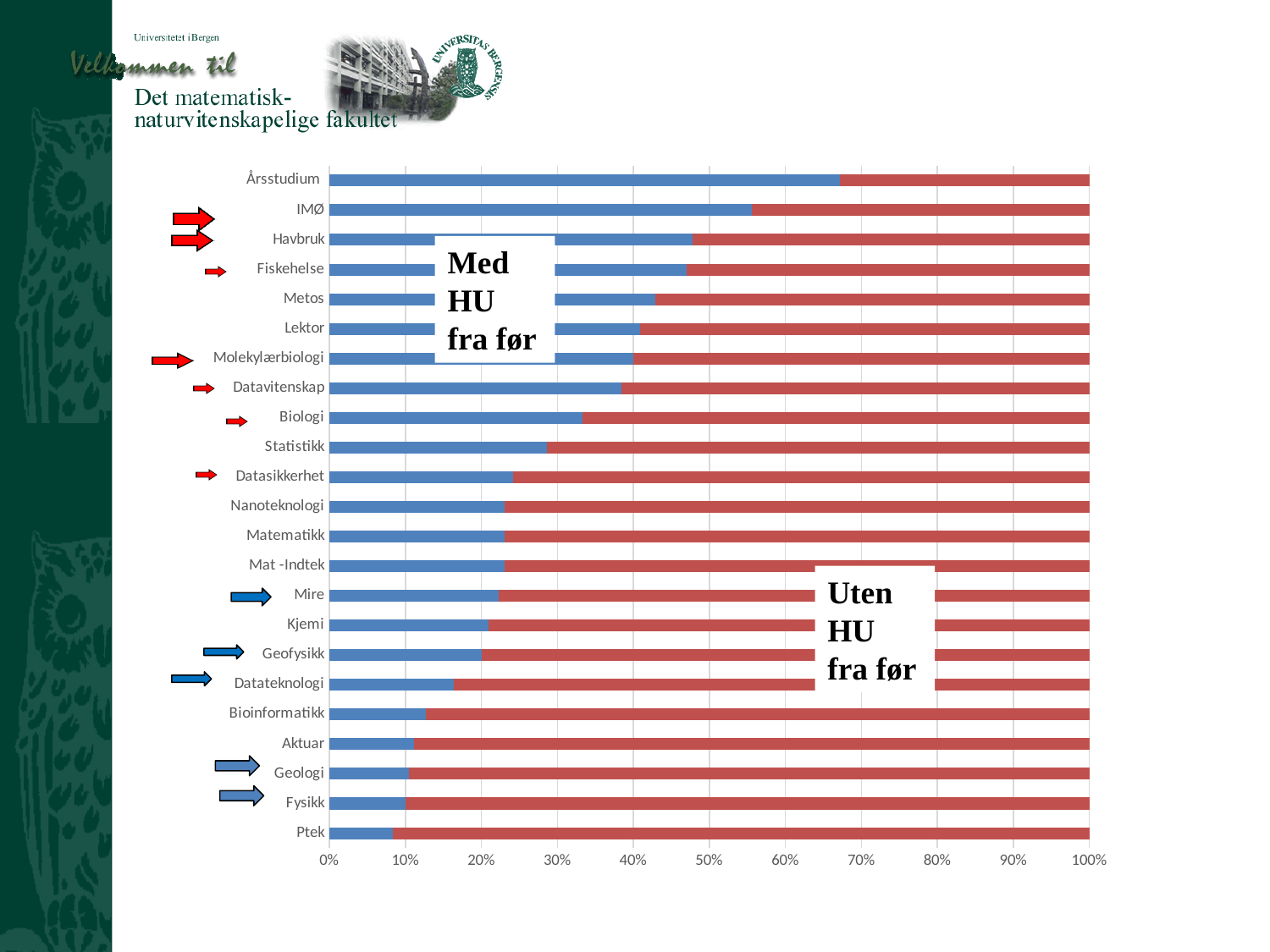
Is the 'Med HU fra før' share for Årsstudium greater or less than 60%? greater What kind of chart is shown on the slide? bar chart Which has the larger 'Med HU fra før' share, Biologi or Statistikk? Biologi Which has the larger 'Med HU fra før' share, Havbruk or Datateknologi? Havbruk Which programme has the smallest 'Med HU fra før' (blue) share? Ptek Is the 'Uten HU fra før' share for Ptek greater or less than 90%? greater Is the 'Med HU fra før' share for Bioinformatikk greater or less than 20%? less What do the blue segments of the bars represent? Med HU fra før How many study programmes (categories) are listed on the vertical axis of the chart? 23 Which programme has the largest 'Med HU fra før' (blue) share? Årsstudium Going from the top of the chart (Årsstudium) to the bottom (Ptek), does the blue 'Med HU fra før' share increase or decrease? decrease